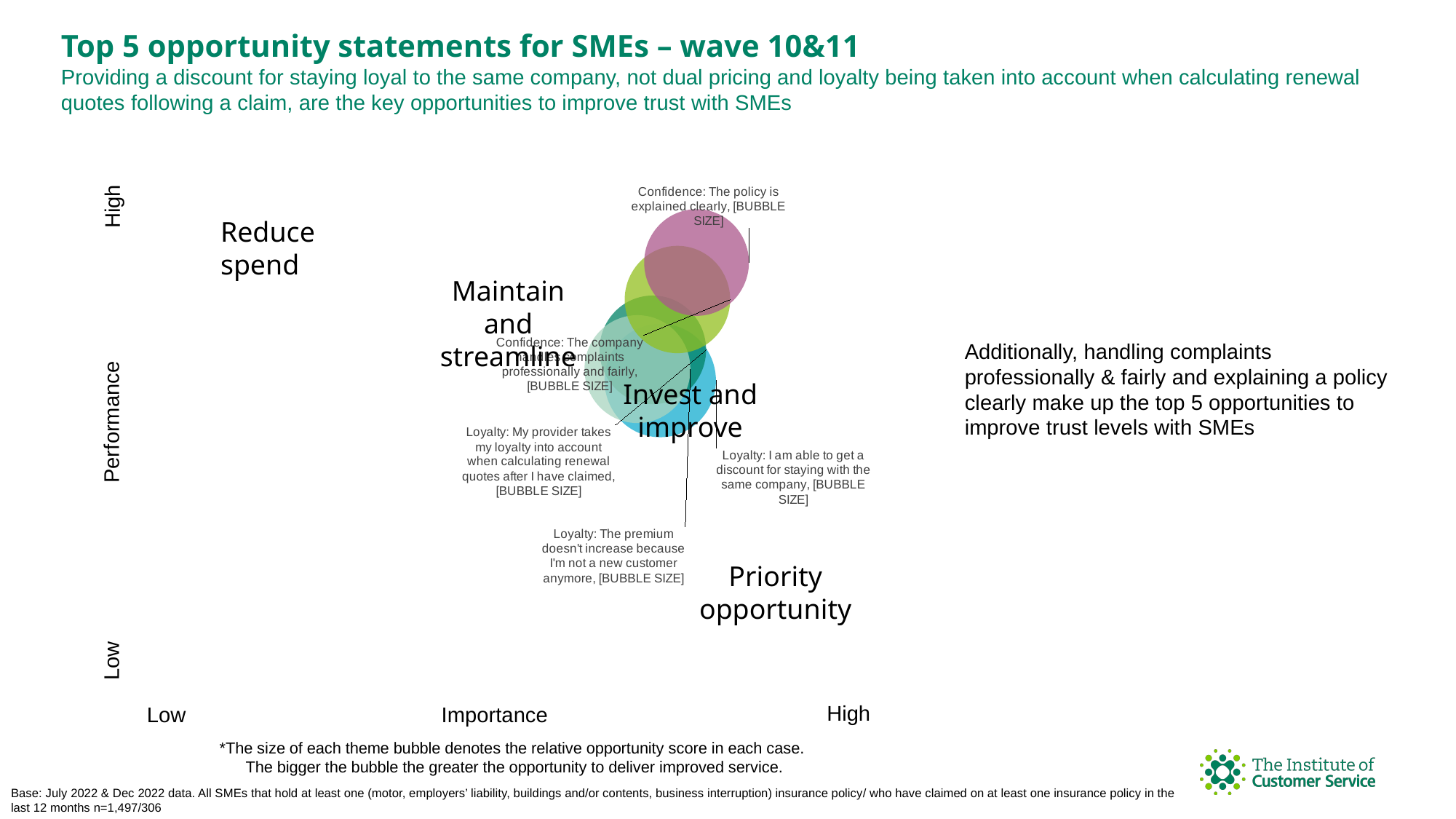
Which opportunity statement is plotted highest on the Performance axis? Confidence: The policy is explained clearly What kind of chart is shown on the slide? Bubble chart Is the bubble for "Confidence: The policy is explained clearly" higher or lower on the Performance axis than the bubble for "Loyalty: I am able to get a discount for staying with the same company"? Higher How many opportunity statements (bubbles) are plotted on the chart? 5 What is the name of the quadrant in the bottom-right of the chart? Priority opportunity What is the label of the horizontal axis of the chart? Importance